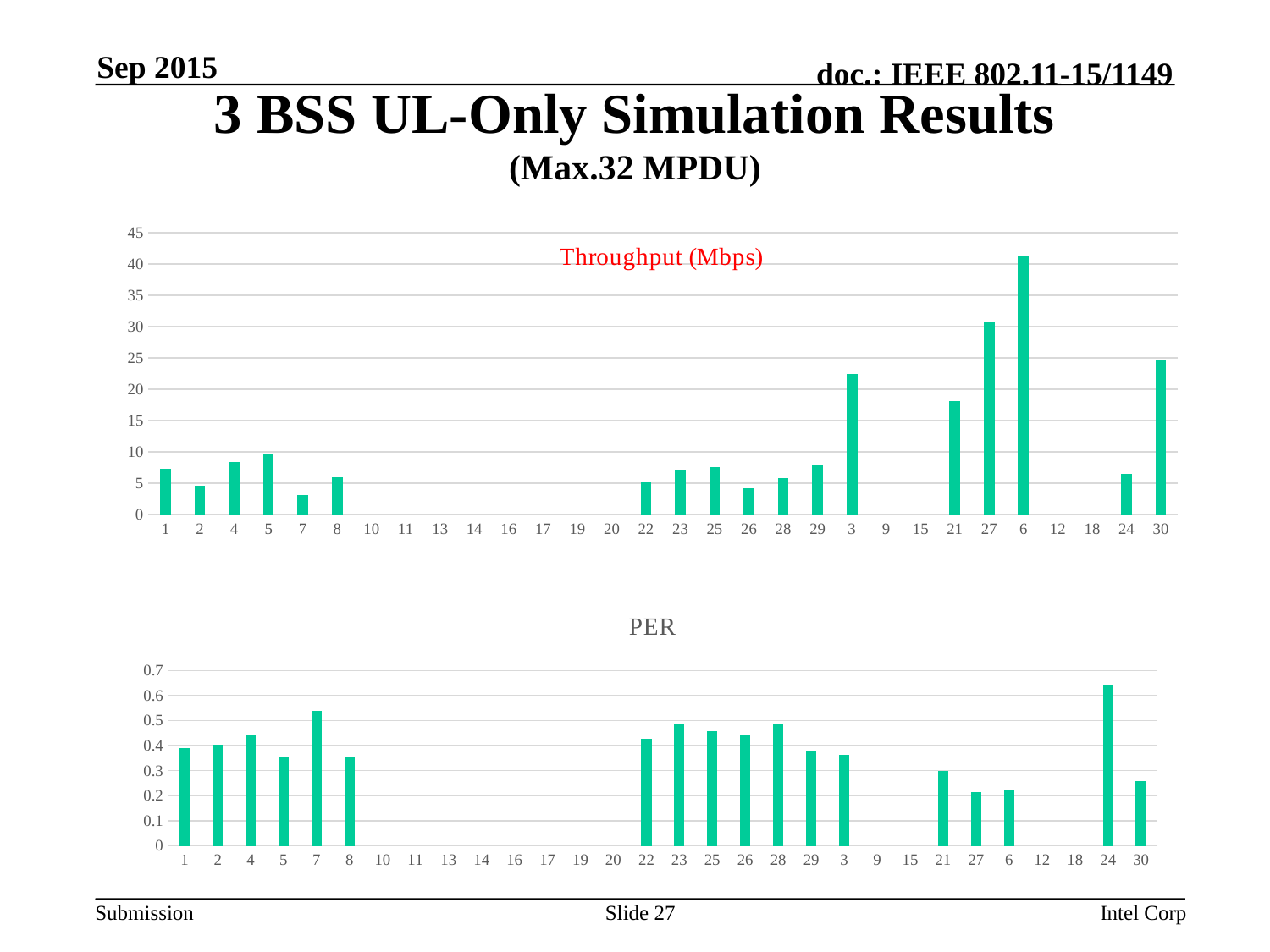
In the Throughput (Mbps) chart, which is larger, the value for category 6 or the value for category 27? 6 In the Throughput (Mbps) chart, is the value for category 3 greater or less than 20? greater In the PER chart, which is larger, the value for category 24 or the value for category 30? 24 How many categories are shown on the x axis of the PER chart? 30 In the Throughput (Mbps) chart, is the value for category 6 greater or less than 35? greater In the PER chart, which category has the highest PER? 24 In the PER chart, is the value for category 7 greater or less than 0.5? greater What kind of chart is the Throughput (Mbps) chart at the top of the slide? bar chart In the Throughput (Mbps) chart, which category has the highest throughput? 6 What is the title of the top chart on the slide? Throughput (Mbps)